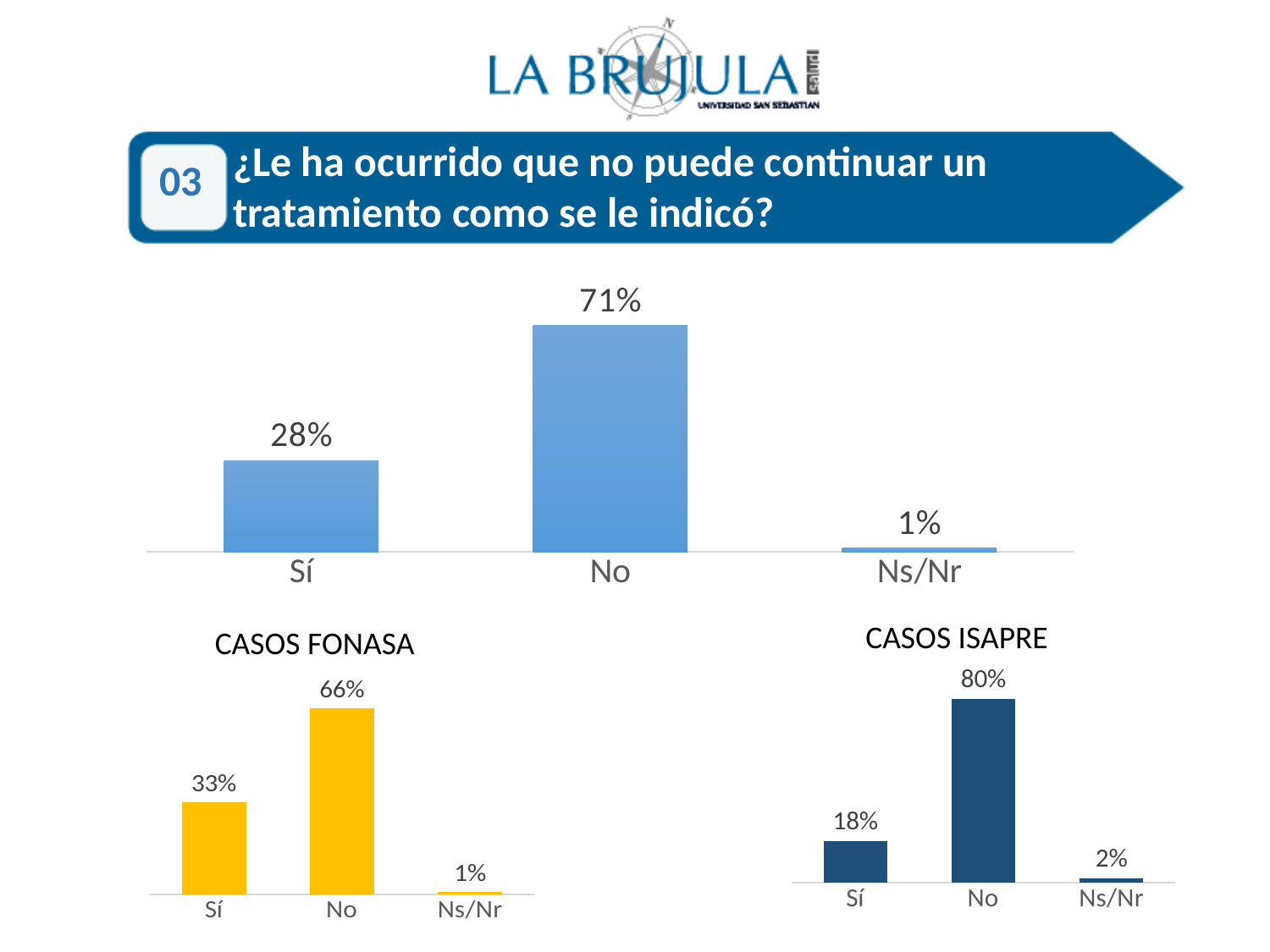
In the top chart, what is the difference between No and Sí? 43% In the top chart, what is the value for No? 71% In the CASOS ISAPRE chart, what is the value for Ns/Nr? 2% What kind of chart is the top chart? Bar chart In the top chart, which category has the lowest value? Ns/Nr How many categories does the CASOS ISAPRE chart show? 3 In the top chart, what is the value for Sí? 28% In the CASOS FONASA chart, what is the difference between No and Sí? 33% In the CASOS ISAPRE chart, what is the value for No? 80% In the CASOS FONASA chart, which category has the highest value? No In the CASOS FONASA chart, what is the value for Sí? 33% Which is larger: the value for Sí in the CASOS FONASA chart or the value for Sí in the CASOS ISAPRE chart? CASOS FONASA